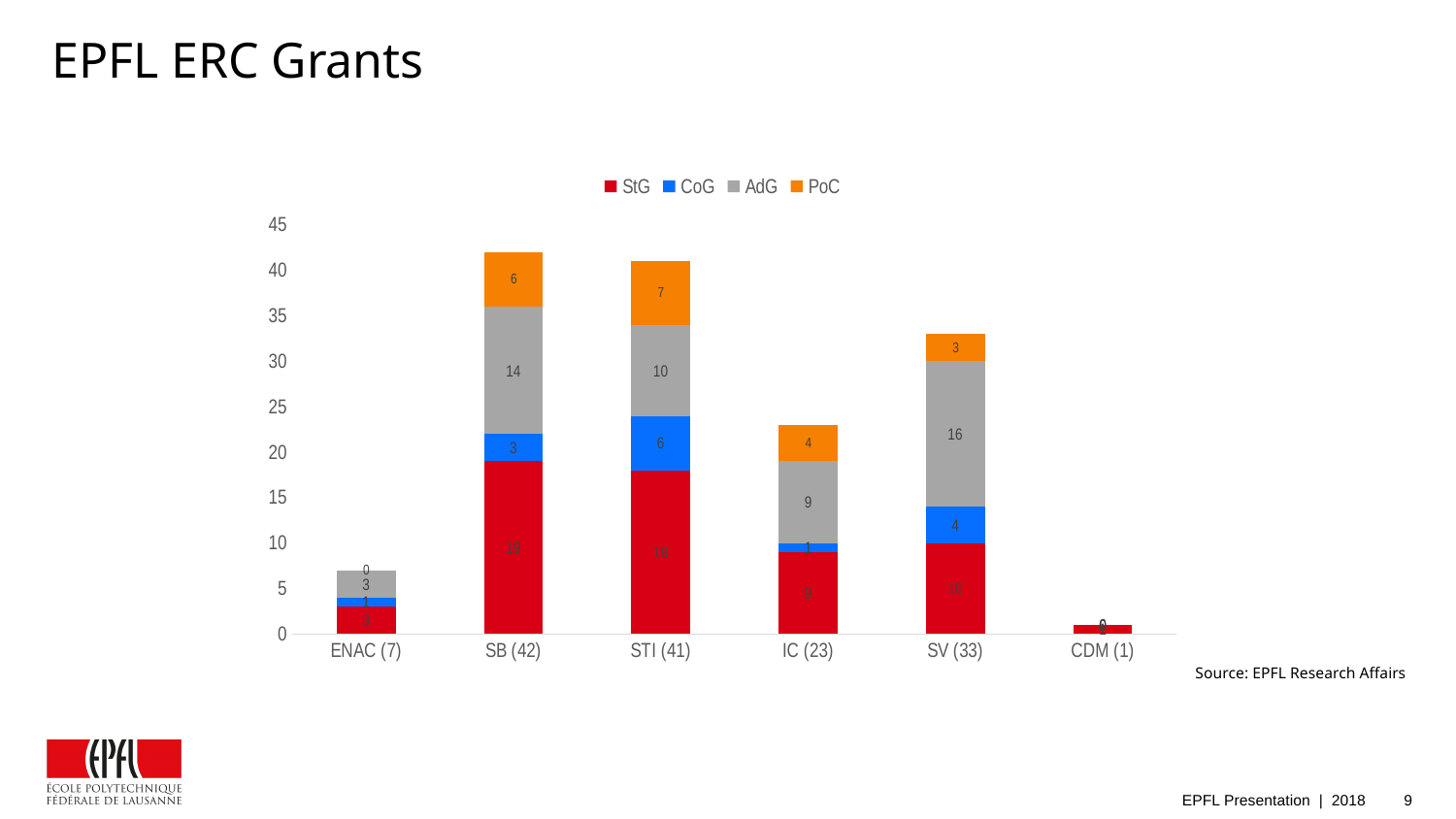
What is the difference between the AdG values for SB (42) and STI (41)? 4 Which category has the highest total stacked bar? SB (42) What is the PoC value for STI (41)? 7 What is the CoG value for SB (42)? 3 What is the AdG value for SV (33)? 16 Which category has the lowest total stacked bar? CDM (1) What kind of chart is shown on the slide? Stacked bar chart Is the total for SV (33) greater or less than 30? greater Which is larger, the StG value for SB (42) or the StG value for STI (41)? SB (42) How many series does the legend list? 4 What is the total of the stacked bar for IC (23)? 23 How many categories are shown on the x axis? 6